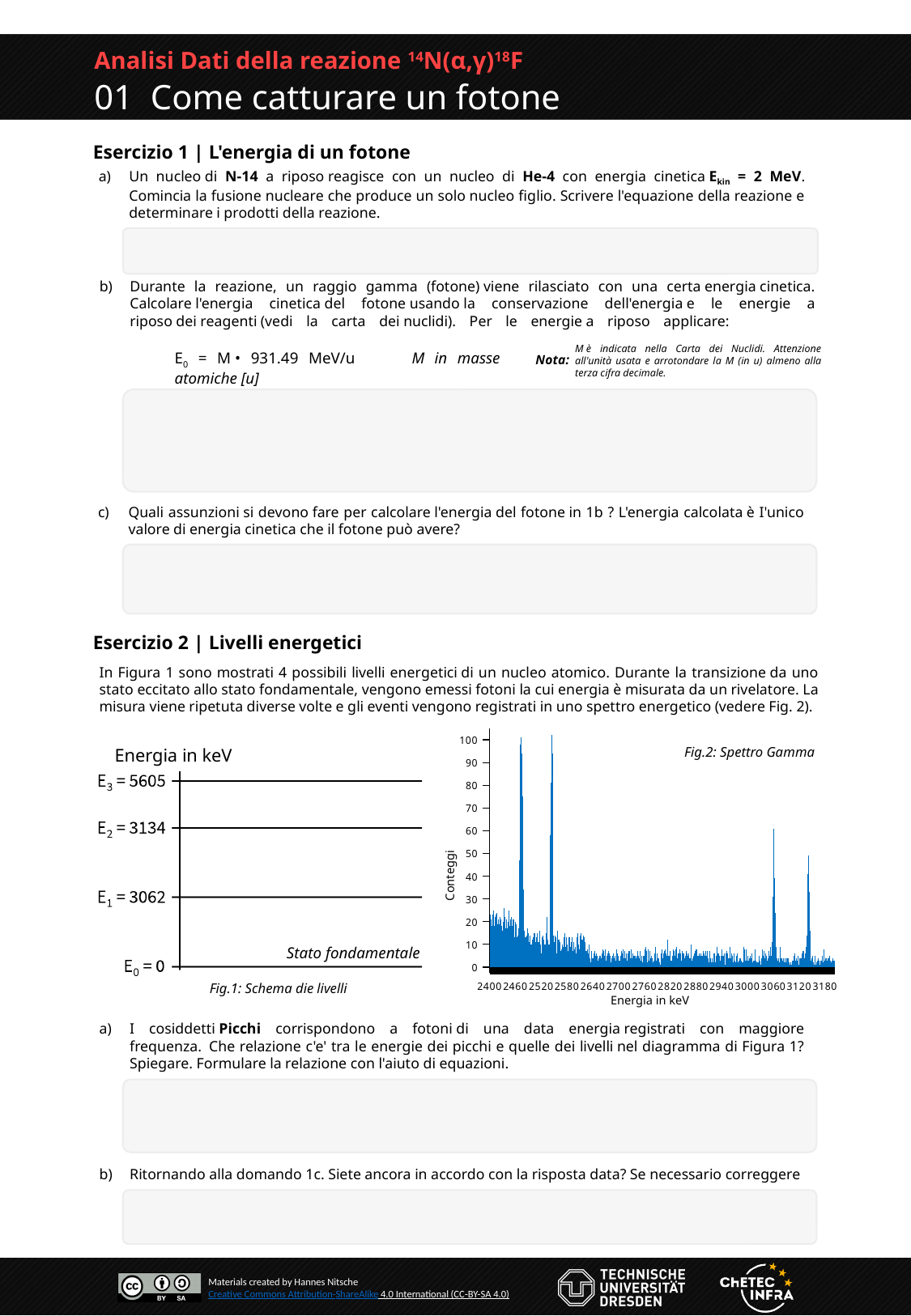
In Fig.1: Schema die livelli, what is the energy of level E2? 3134 keV In Fig.2: Spettro Gamma, what is the label of the y axis? Conteggi In Fig.2: Spettro Gamma, what is the maximum value shown on the y axis? 100 In Fig.2: Spettro Gamma, is the peak near 3130 keV greater or less than 40 counts? greater In Fig.2: Spettro Gamma, what is the label of the x axis? Energia in keV In Fig.1: Schema die livelli, what is the energy of level E3? 5605 keV In Fig.2: Spettro Gamma, is the tallest peak greater or less than 90 counts? greater In Fig.2: Spettro Gamma, is the peak near 3060 keV greater or less than 50 counts? greater In Fig.1: Schema die livelli, which level has the highest energy? E3 In Fig.1: Schema die livelli, how many energy levels are shown? 4 In Fig.1: Schema die livelli, what is the difference in energy between E2 and E1? 72 keV In Fig.2: Spettro Gamma, is the peak near 3060 keV higher or lower than the peak near 3130 keV? higher